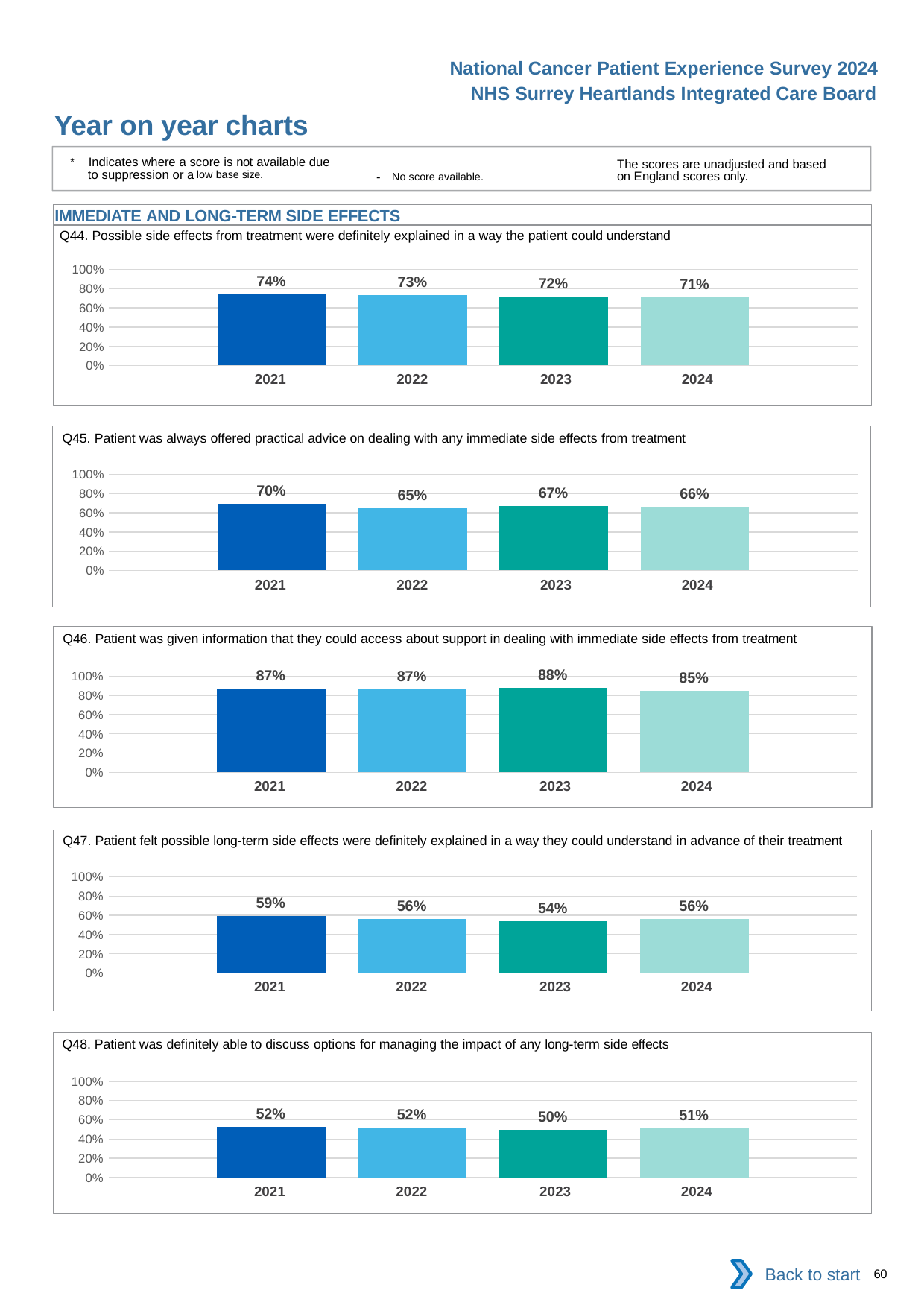
In the Q46 chart, what is the value for 2024? 85% What kind of chart is the Q48 chart? bar chart In the Q48 chart, what is the difference between the 2022 and 2023 values? 2 percentage points In the Q47 chart, what is the value for 2023? 54% In the Q45 chart, which year has the lowest value? 2022 In the Q44 chart, do the values rise or fall from 2021 to 2024? fall In the Q44 chart, what is the value for 2021? 74% In the Q44 chart, is the value for 2024 greater or less than 60%? greater In the Q46 chart, which year has the highest value? 2023 In the Q47 chart, which is larger, the value for 2021 or the value for 2023? 2021 In the Q48 chart, how many years are plotted? 4 In the Q45 chart, what is the difference between the 2021 and 2024 values? 4 percentage points